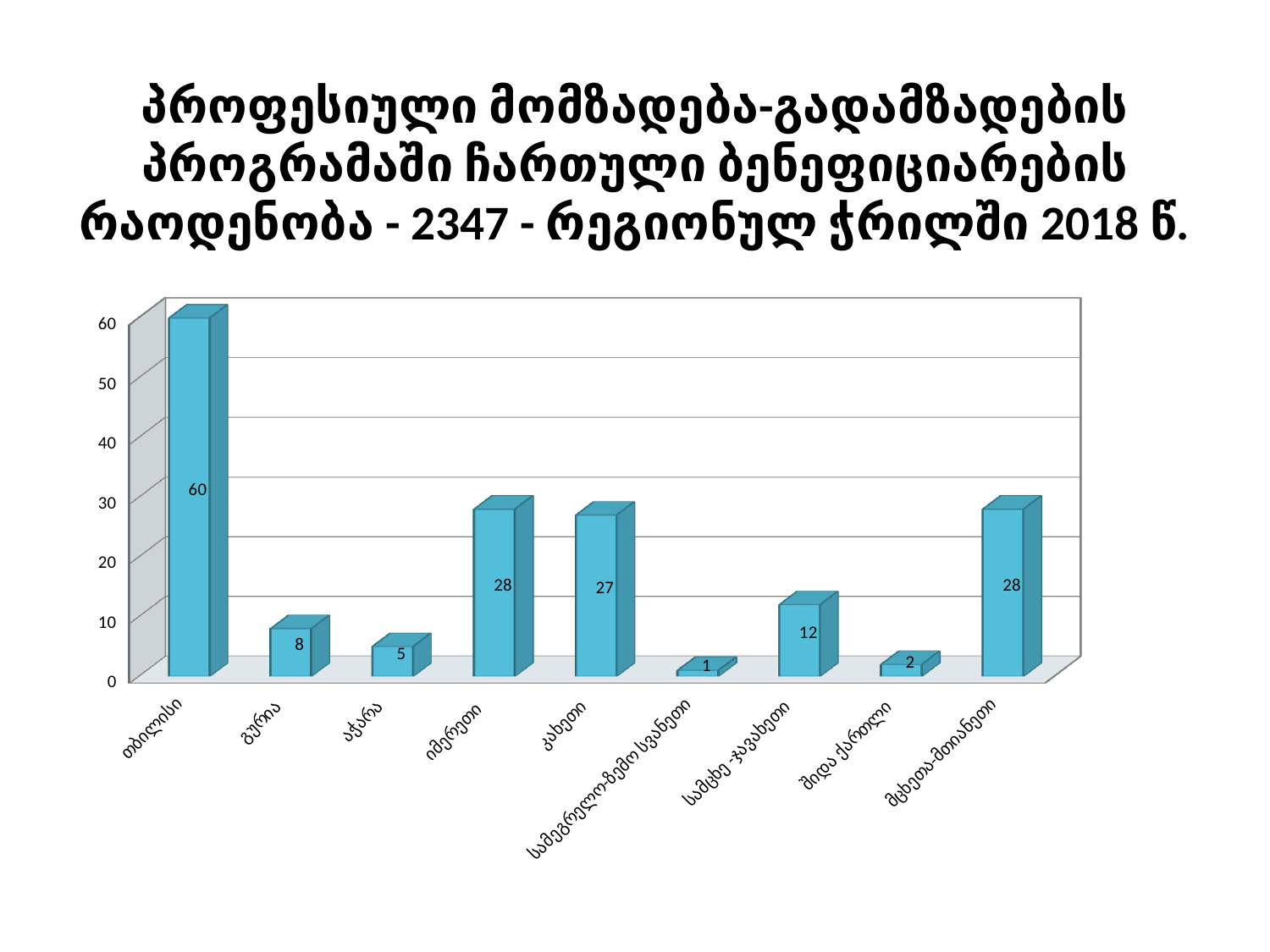
What is the difference between the values for სამცხე-ჯავახეთი and გურია? 4 What is the value for შიდა ქართლი? 2 Which region has the highest value? თბილისი What is the value for თბილისი? 60 What is the value for აჭარა? 5 What is the value for სამცხე-ჯავახეთი? 12 Which is larger, the value for იმერეთი or the value for კახეთი? იმერეთი How many regions (categories) are shown on the chart? 9 What is the difference between the values for თბილისი and იმერეთი? 32 Which region has the lowest value? სამეგრელო-ზემო სვანეთი What type of chart is shown on the slide? bar chart Is the value for თბილისი greater or less than 50? greater